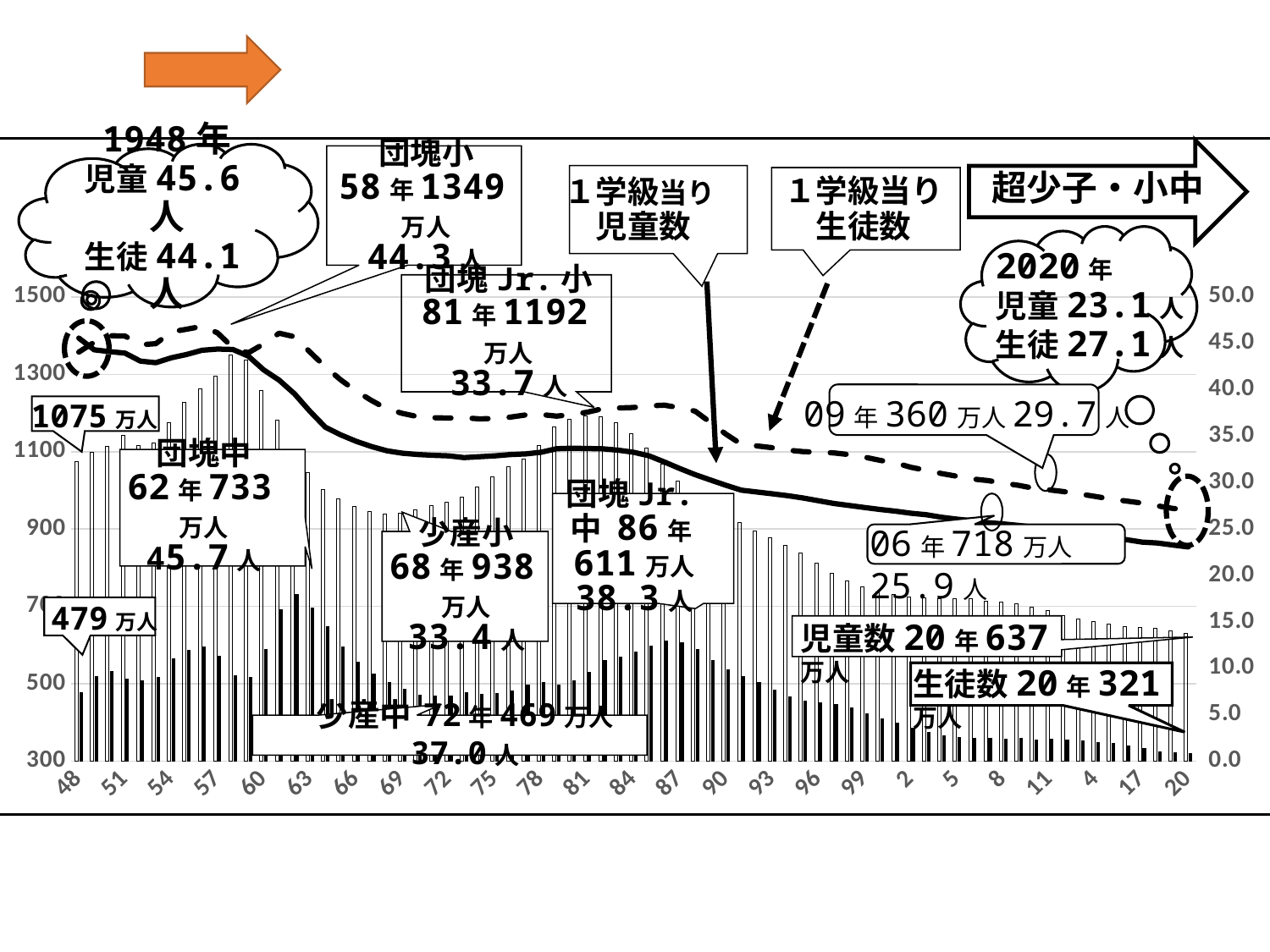
What is the number of students per class (1学級当り生徒数) in 2020 according to the chart? 27.1人 What is the difference between the 2020 elementary school children count (637万人) and the 2020 junior high student count (321万人)? 316万人 What is the number of junior high students (生徒数) in 1948 according to the label on the chart? 479万人 What is the number of elementary school children (児童数) in 2020 according to the chart? 637万人 What kind of chart is shown on the slide? Combination bar and line chart By how much does the 1958 elementary school children count (1349万人) exceed the 1981 count (1192万人)? 157万人 Which year has the higher number of elementary children per class (1学級当り児童数): 1948 (45.6人) or 2020 (23.1人)? 1948 What is the number of junior high students (生徒数) in 2020 according to the chart? 321万人 What is the number of elementary school children (児童数) in 1948 according to the label on the chart? 1075万人 What is the number of elementary school children in 1981 (団塊Jr.小) according to the chart? 1192万人 What is the number of elementary school children in 1958 (団塊小) according to the chart? 1349万人 Does the number of elementary children per class (1学級当り児童数, solid line) rise or fall overall from 1948 to 2020? fall